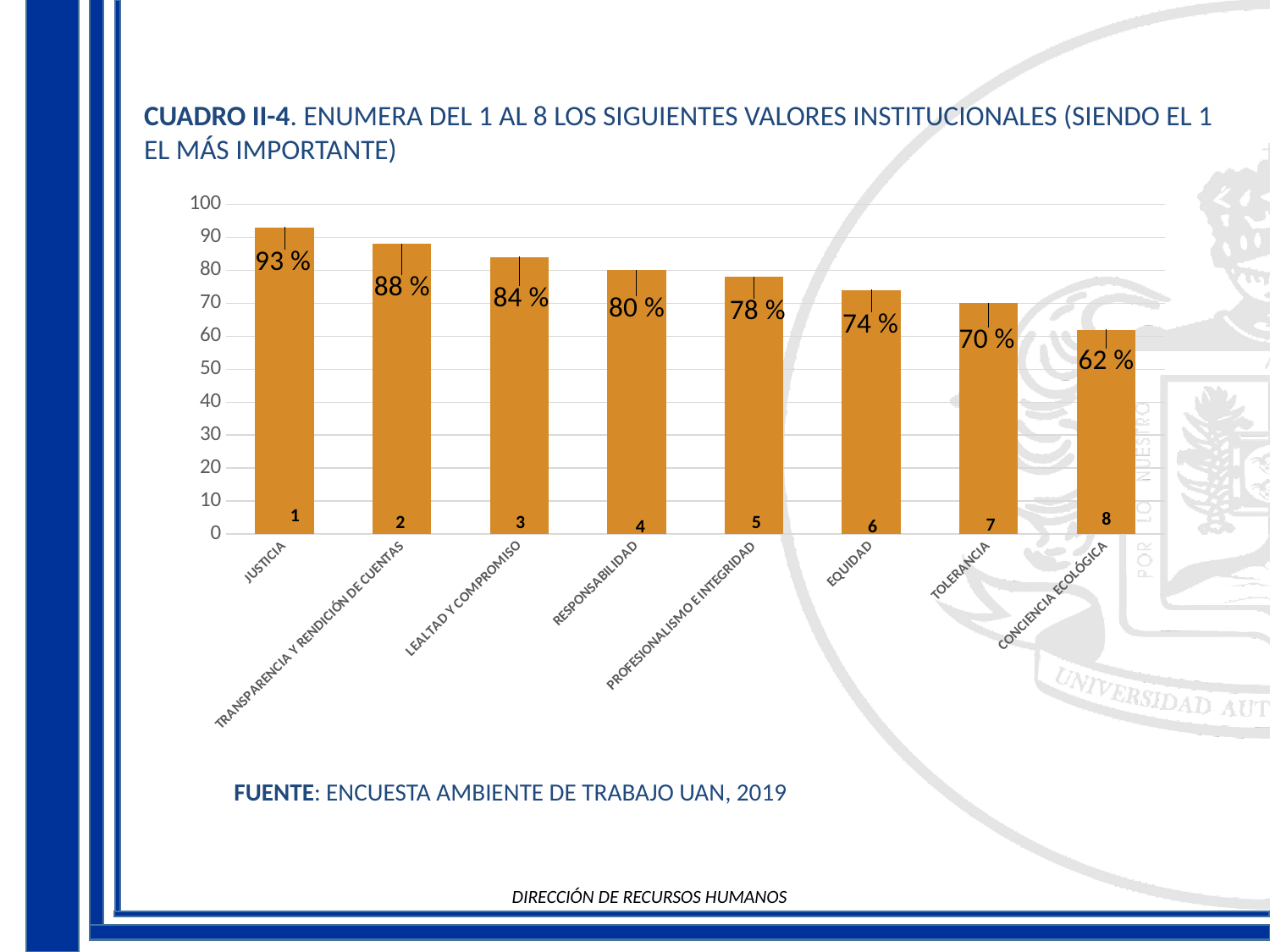
What is the value for EQUIDAD? 74 % What kind of chart is shown on the slide? Bar chart Which category has the highest value? JUSTICIA What rank number is printed at the base of the bar for TRANSPARENCIA Y RENDICIÓN DE CUENTAS? 2 What is the value for JUSTICIA? 93 % Do the values rise or fall from left to right along the x axis? Fall Which category has the lowest value? CONCIENCIA ECOLÓGICA How many categories are shown in the chart? 8 What is the value for TOLERANCIA? 70 % What is the difference between the values for JUSTICIA and CONCIENCIA ECOLÓGICA? 31 % Is the value for PROFESIONALISMO E INTEGRIDAD greater or less than 70? greater Which is larger, the value for LEALTAD Y COMPROMISO or the value for RESPONSABILIDAD? LEALTAD Y COMPROMISO